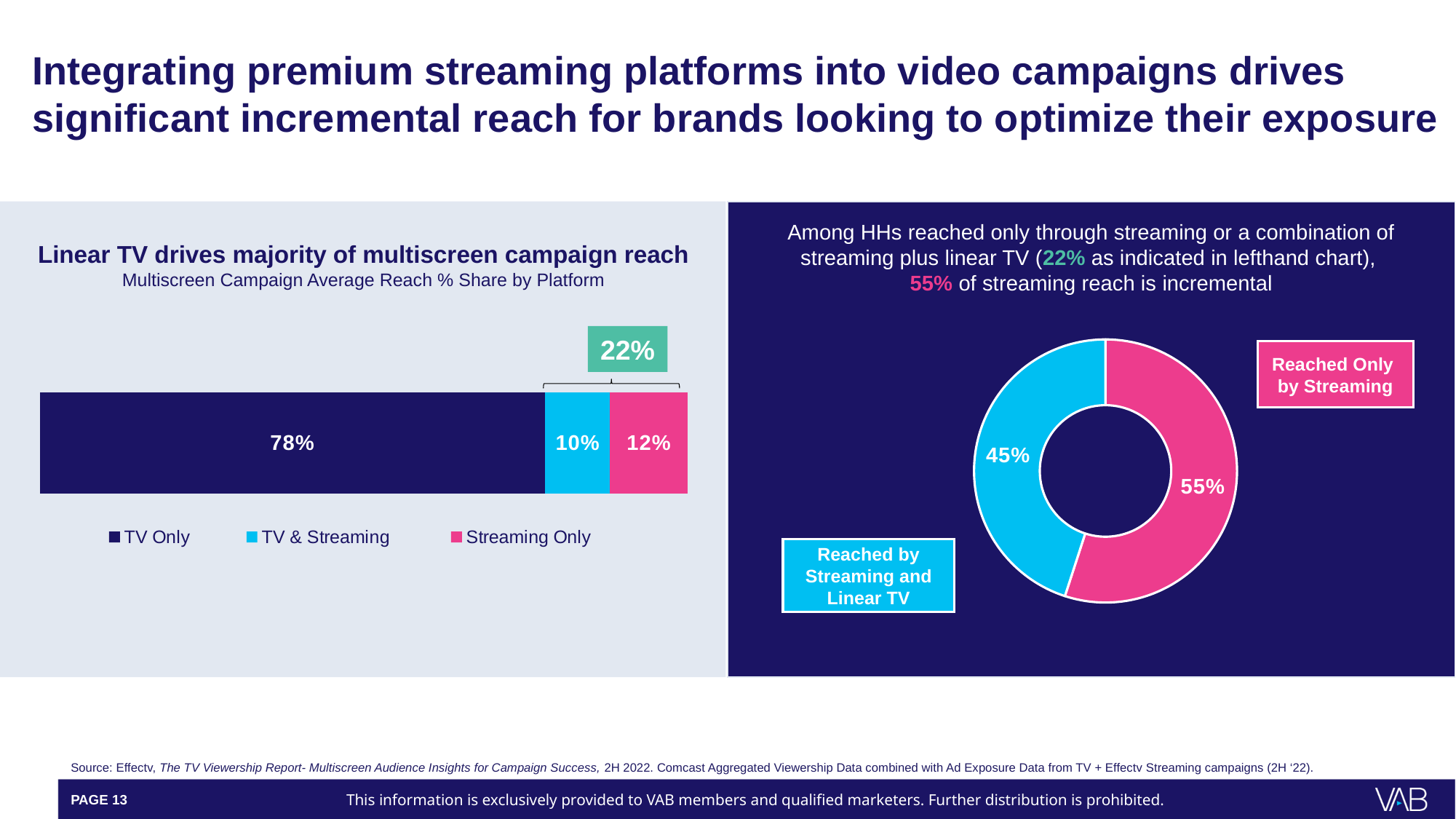
In the left chart 'Linear TV drives majority of multiscreen campaign reach', which platform has the smallest share? TV & Streaming In the donut chart on the right, which segment is larger: Reached Only by Streaming or Reached by Streaming and Linear TV? Reached Only by Streaming In the left chart 'Linear TV drives majority of multiscreen campaign reach', what is the value for TV & Streaming? 10% In the donut chart on the right, what share is Reached by Streaming and Linear TV? 45% In the left chart 'Linear TV drives majority of multiscreen campaign reach', what is the combined share of TV & Streaming and Streaming Only? 22% What kind of chart is the left chart 'Linear TV drives majority of multiscreen campaign reach'? Stacked bar chart In the donut chart on the right, what share is Reached Only by Streaming? 55% In the left chart 'Linear TV drives majority of multiscreen campaign reach', which platform has the largest share? TV Only How many series does the legend of the left chart 'Linear TV drives majority of multiscreen campaign reach' list? 3 In the left chart 'Linear TV drives majority of multiscreen campaign reach', what is the difference between the TV Only share and the Streaming Only share? 66% In the left chart 'Linear TV drives majority of multiscreen campaign reach', what is the value for Streaming Only? 12% In the left chart 'Linear TV drives majority of multiscreen campaign reach', what is the value for TV Only? 78%